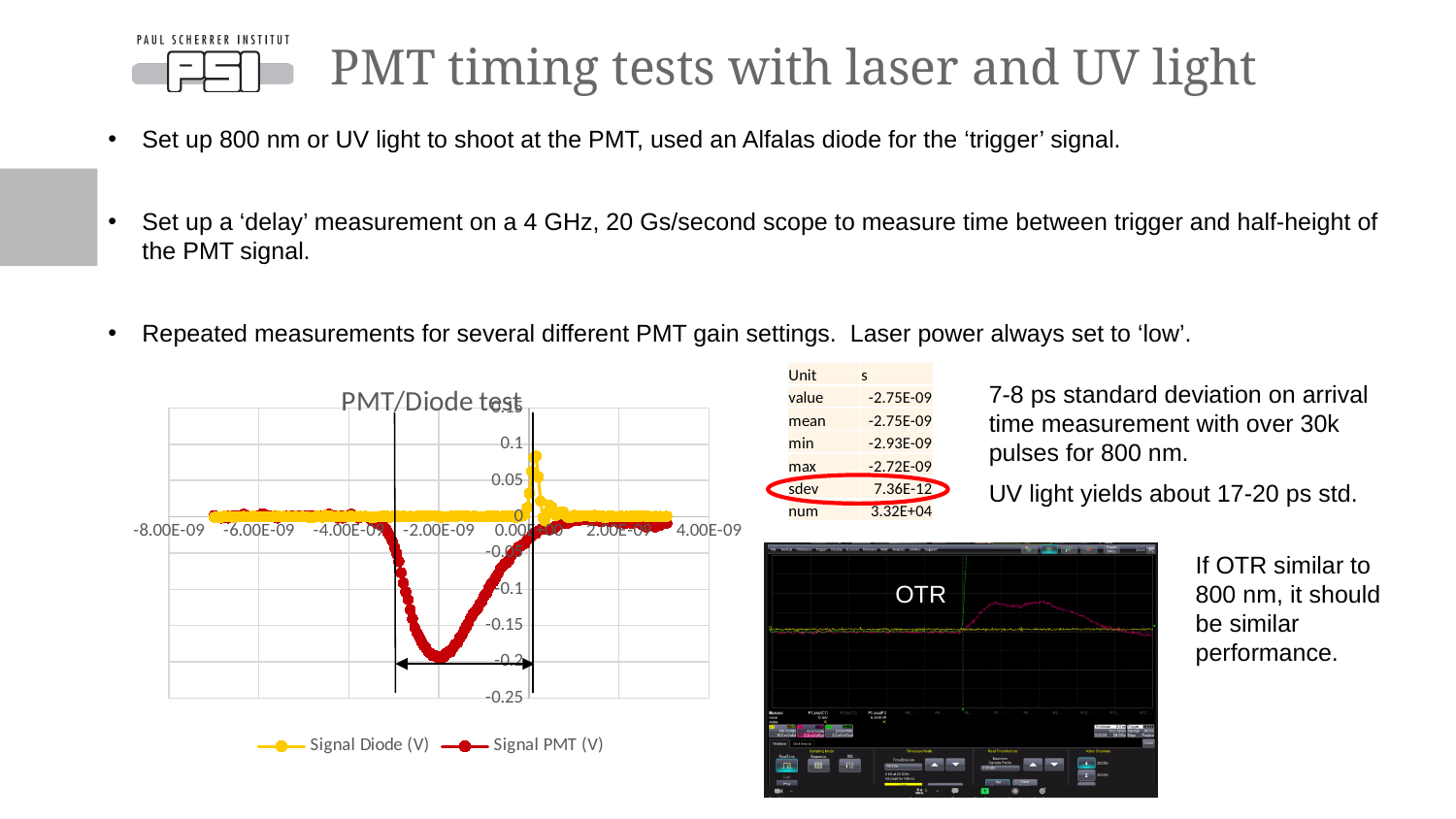
In the PMT/Diode test chart, is the lowest value of Signal PMT (V) greater or less than -0.25? greater In the PMT/Diode test chart, is the lowest value of Signal PMT (V) greater or less than -0.1? less What kind of chart is the PMT/Diode test chart? Scatter (line) chart How many series does the legend of the PMT/Diode test chart list? 2 In the PMT/Diode test chart, is the peak value of Signal Diode (V) greater or less than 0.05? greater In the PMT/Diode test chart, does Signal PMT (V) rise or fall between about -2.00E-09 and 0.00E+00 on the x axis? rise In the PMT/Diode test chart, which series reaches the lower minimum value, Signal Diode (V) or Signal PMT (V)? Signal PMT (V) In the PMT/Diode test chart, which series shows a positive peak above 0, Signal Diode (V) or Signal PMT (V)? Signal Diode (V) What is the title of the chart on the left of the slide? PMT/Diode test In the PMT/Diode test chart, which colour represents Signal PMT (V)? Red